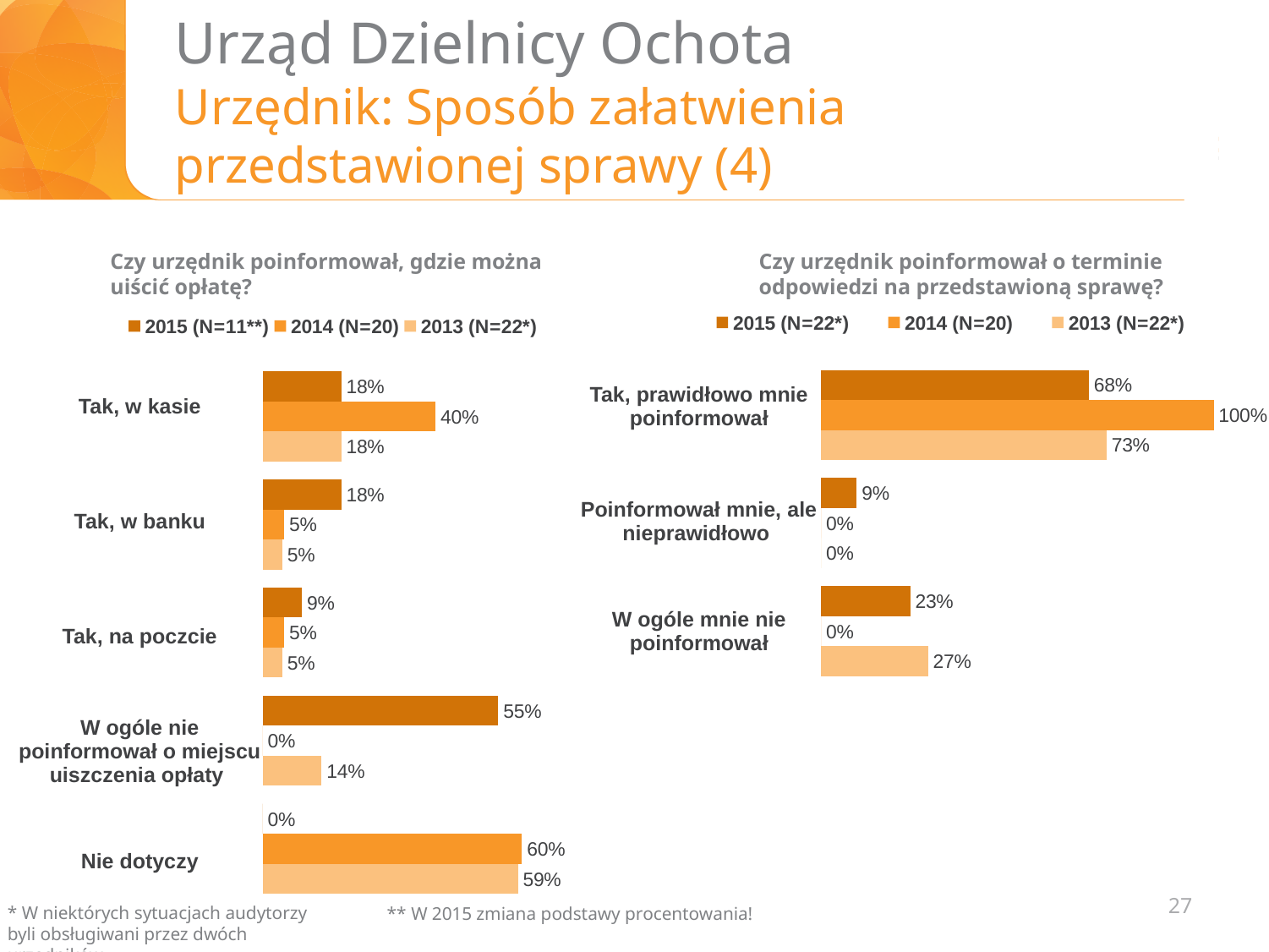
In the right chart, what is the 2013 value for "W ogóle mnie nie poinformował"? 27% In the left chart, what is the 2015 value for "W ogóle nie poinformował o miejscu uiszczenia opłaty"? 55% In the right chart ("Czy urzędnik poinformował o terminie odpowiedzi na przedstawioną sprawę?"), what is the 2014 value for "Tak, prawidłowo mnie poinformował"? 100% How many series does the legend of the right chart list? 3 In the left chart, which category has the highest 2014 value? Nie dotyczy What type of chart is the left chart? Bar chart In the left chart, what is the 2013 value for "Nie dotyczy"? 59% In the right chart, which is larger for "Tak, prawidłowo mnie poinformował": the 2015 value or the 2013 value? 2013 (73%) In the left chart, how many categories are shown? 5 In the right chart, what is the difference between the 2013 and 2015 values for "W ogóle mnie nie poinformował"? 4 percentage points In the left chart ("Czy urzędnik poinformował, gdzie można uiścić opłatę?"), what is the 2014 value for "Tak, w kasie"? 40% In the left chart, what is the difference between the 2014 and 2015 values for "Tak, w kasie"? 22 percentage points